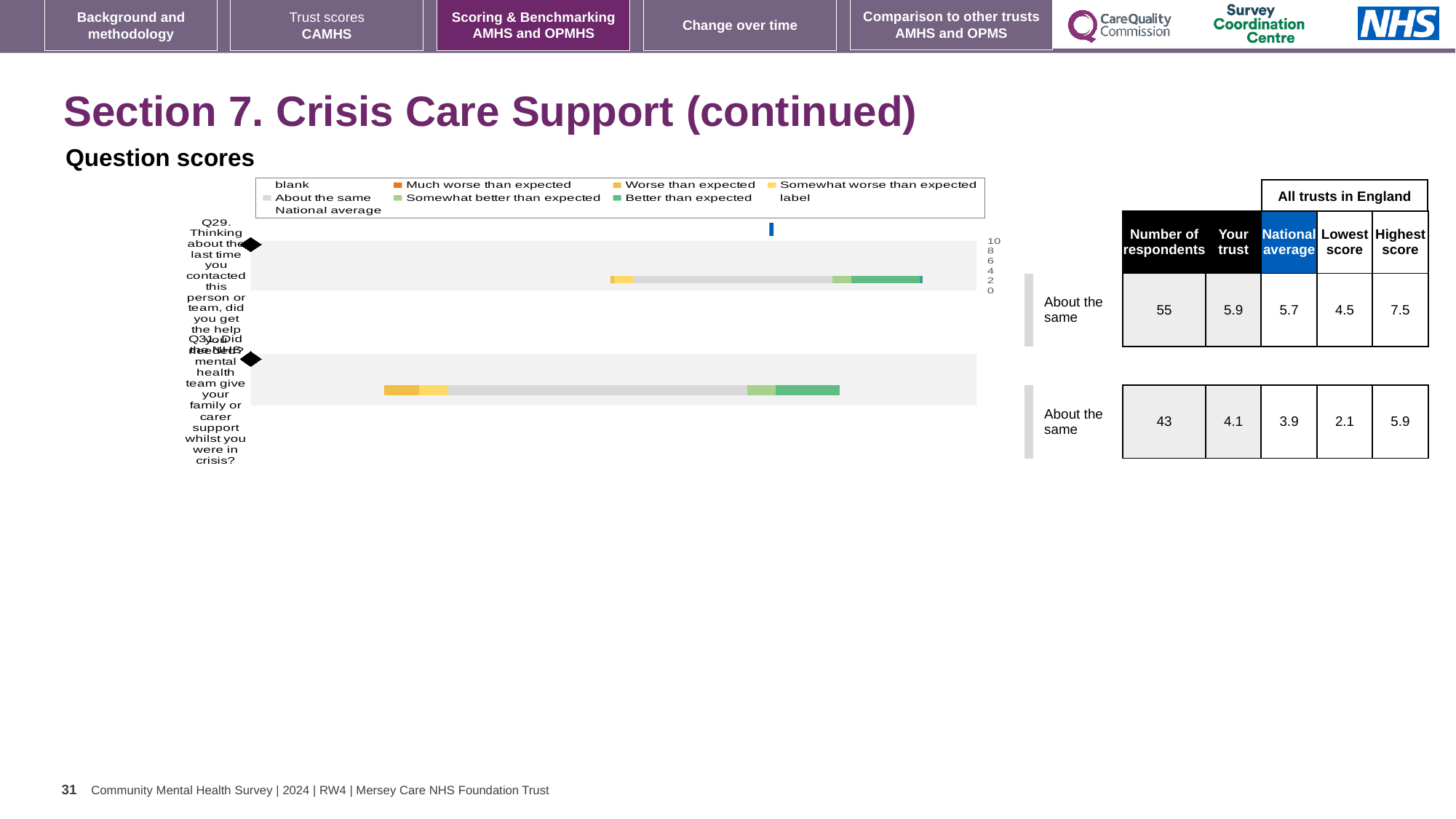
In the table next to the chart, what is the national average for Q31? 3.9 In the table next to the chart, what is the difference between the highest score and lowest score for Q29? 3.0 What kind of chart is shown under 'Question scores'? bar chart In the table next to the chart, what is the difference between the 'Your trust' score and the national average for Q31? 0.2 How many questions (bars) are plotted in the chart? 2 Which legend entry is shown in grey in the chart? About the same In the table next to the chart, what is the 'Your trust' score for Q31? 4.1 In the table next to the chart, what is the 'Your trust' score for Q29? 5.9 In the table next to the chart, which question has the higher 'Your trust' score, Q29 or Q31? Q29 In the table next to the chart, what is the number of respondents for Q29? 55 What is the highest tick value shown on the chart's numeric axis? 10 How many entries does the chart legend list? 9